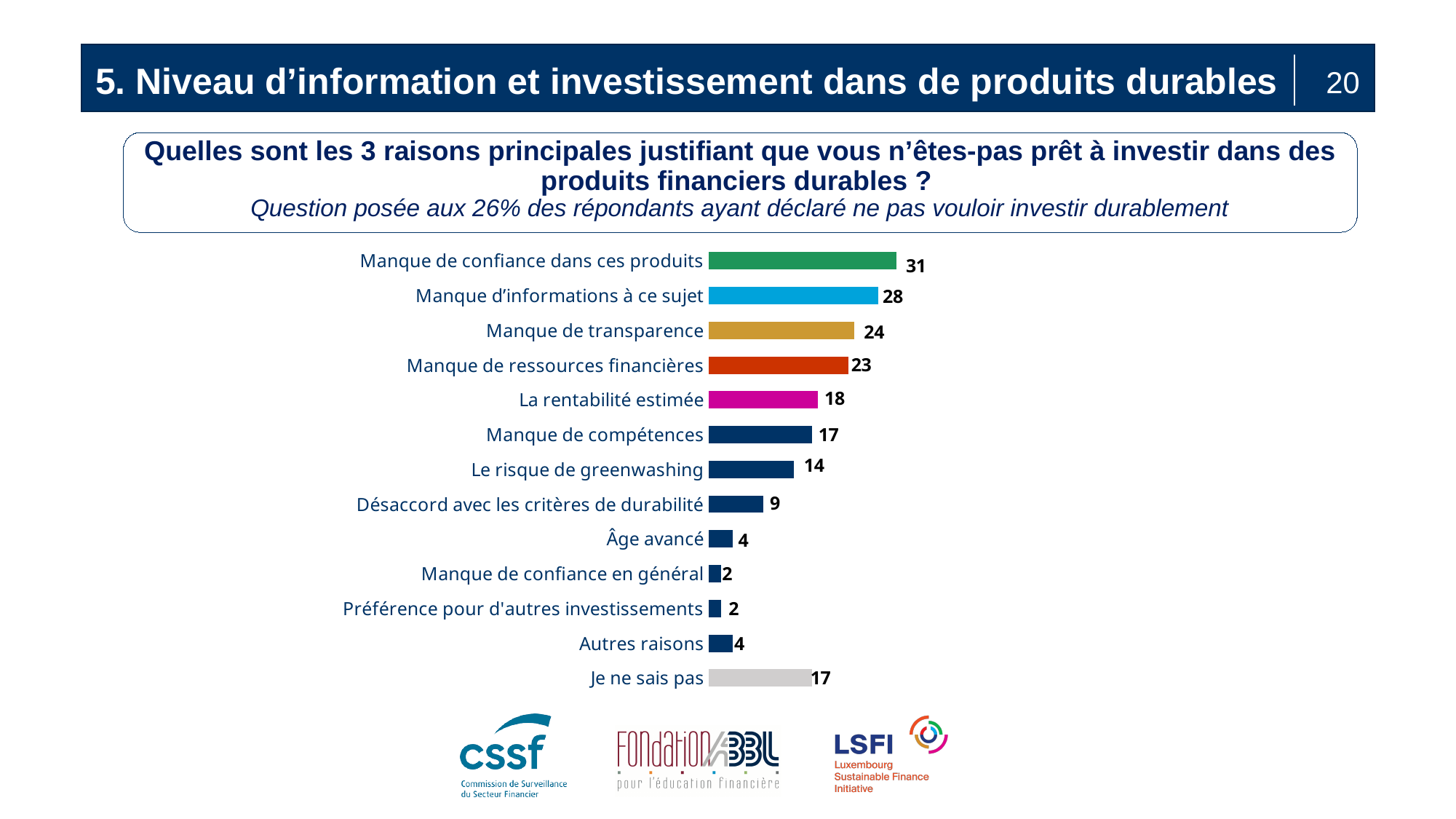
What is the value for "Manque de transparence"? 24 Which category has the highest value? Manque de confiance dans ces produits What colour is the bar for "Je ne sais pas"? Grey What is the value for "Manque de confiance dans ces produits"? 31 What is the difference between "Manque de confiance dans ces produits" and "La rentabilité estimée"? 13 How many categories are shown in the chart? 13 What kind of chart is shown on the slide? Bar chart What is the difference between "Manque d'informations à ce sujet" and "Manque de ressources financières"? 5 Which is larger, the value for "Manque de compétences" or the value for "Désaccord avec les critères de durabilité"? Manque de compétences What is the value for "Je ne sais pas"? 17 Which is larger, the value for "Âge avancé" or the value for "Le risque de greenwashing"? Le risque de greenwashing What is the value for "Le risque de greenwashing"? 14